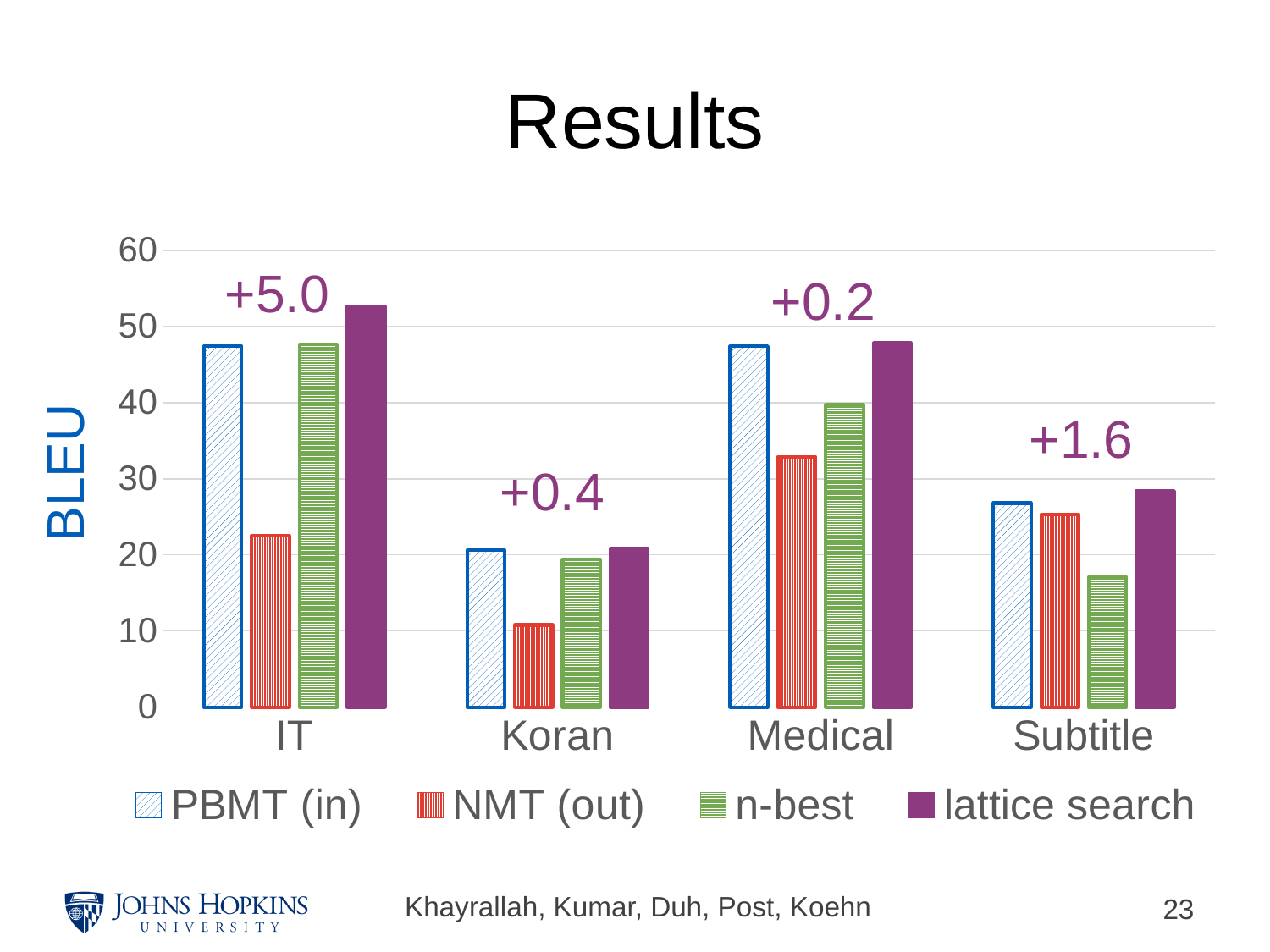
Which series has the lowest value in the Subtitle category? n-best Which category has the highest lattice search value? IT In the Subtitle category, which is larger: NMT (out) or n-best? NMT (out) What kind of chart is shown on the slide? bar chart How many series does the legend list? 4 What annotation is printed above the IT group of bars? +5.0 Is the value for NMT (out) in the Medical category greater or less than 30? greater Is the value for NMT (out) in the IT category greater or less than 30? less Which category has the lowest NMT (out) value? Koran In the Medical category, which is larger: NMT (out) or n-best? n-best Is the value for lattice search in the IT category greater or less than 50? greater How many categories are shown on the x axis of the chart? 4